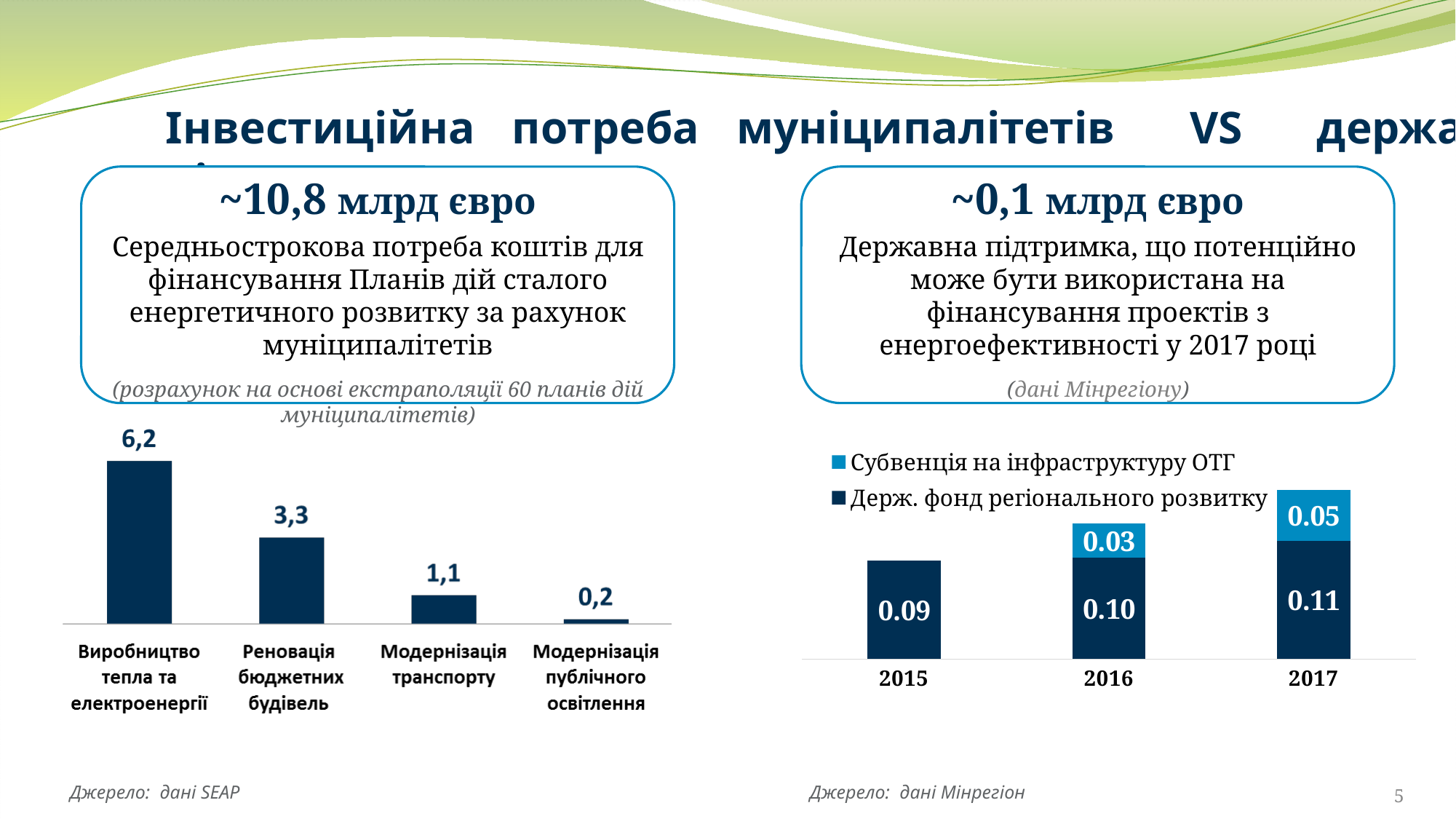
On the left chart, which category has the lowest value? Модернізація публічного освітлення On the left chart, what is the value for Модернізація транспорту? 1,1 On the right chart, what is the value of Субвенція на інфраструктуру ОТГ in 2017? 0.05 On the left chart, what is the value for Виробництво тепла та електроенергії? 6,2 What kind of chart is the left chart? Bar chart How many categories are shown on the left chart? 4 On the right chart, does the value of Держ. фонд регіонального розвитку rise or fall from 2015 to 2017? Rise On the right chart, what is the value of Держ. фонд регіонального розвитку in 2016? 0.10 How many series does the legend of the right chart list? 2 On the right chart, what is the total of the stacked bar for 2017? 0.16 On the left chart, what is the difference between Виробництво тепла та електроенергії and Реновація бюджетних будівель? 2,9 On the left chart, which category has the highest value? Виробництво тепла та електроенергії